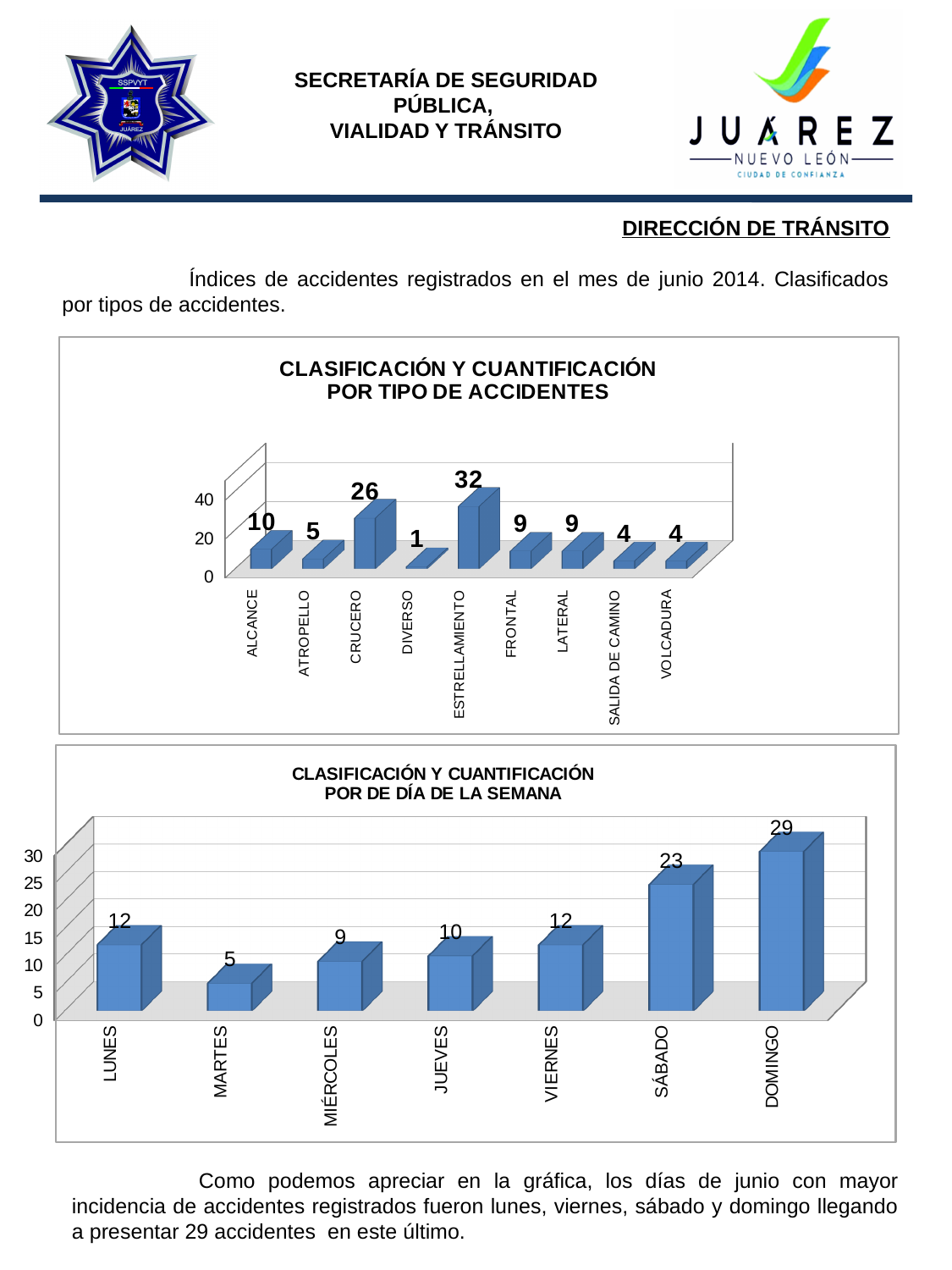
In the chart 'CLASIFICACIÓN Y CUANTIFICACIÓN POR TIPO DE ACCIDENTES', which category has the lowest value? DIVERSO In the chart 'CLASIFICACIÓN Y CUANTIFICACIÓN POR DE DÍA DE LA SEMANA', which day has the highest value? DOMINGO What kind of chart is 'CLASIFICACIÓN Y CUANTIFICACIÓN POR DE DÍA DE LA SEMANA'? Bar chart In the chart 'CLASIFICACIÓN Y CUANTIFICACIÓN POR TIPO DE ACCIDENTES', which category has the highest value? ESTRELLAMIENTO In the chart 'CLASIFICACIÓN Y CUANTIFICACIÓN POR TIPO DE ACCIDENTES', what is the value for CRUCERO? 26 In the chart 'CLASIFICACIÓN Y CUANTIFICACIÓN POR TIPO DE ACCIDENTES', which is larger, ALCANCE or ATROPELLO? ALCANCE In the chart 'CLASIFICACIÓN Y CUANTIFICACIÓN POR DE DÍA DE LA SEMANA', how many days are shown? 7 In the chart 'CLASIFICACIÓN Y CUANTIFICACIÓN POR TIPO DE ACCIDENTES', what is the difference between ESTRELLAMIENTO and CRUCERO? 6 In the chart 'CLASIFICACIÓN Y CUANTIFICACIÓN POR DE DÍA DE LA SEMANA', what is the value for SÁBADO? 23 In the chart 'CLASIFICACIÓN Y CUANTIFICACIÓN POR TIPO DE ACCIDENTES', how many categories are shown? 9 In the chart 'CLASIFICACIÓN Y CUANTIFICACIÓN POR DE DÍA DE LA SEMANA', what is the difference between DOMINGO and SÁBADO? 6 In the chart 'CLASIFICACIÓN Y CUANTIFICACIÓN POR DE DÍA DE LA SEMANA', which day has the lowest value? MARTES